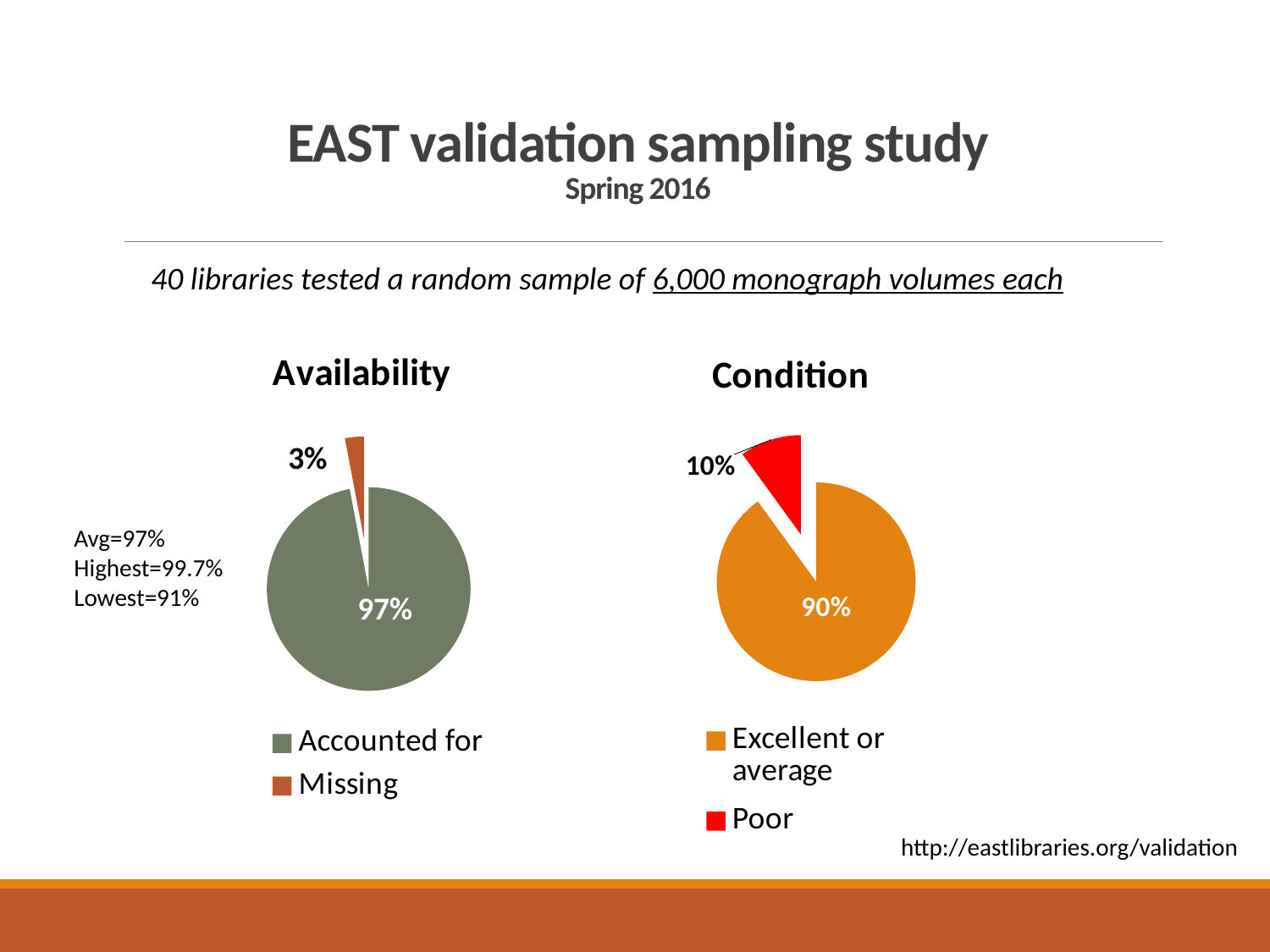
In the Condition pie chart, what percentage is labelled for Poor? 10% In the Availability pie chart, what percentage is labelled for Accounted for? 97% In the Condition pie chart, what is the difference between the Excellent or average and Poor percentages? 80% In the Availability pie chart, what is the difference between the Accounted for and Missing percentages? 94% In the Condition pie chart, what colour is the Poor slice? Red What type of chart is the Condition chart? Pie chart In the Availability pie chart, which slice is the largest? Accounted for In the Condition pie chart, what percentage is labelled for Excellent or average? 90% In the Availability pie chart, what percentage is labelled for Missing? 3% In the Condition pie chart, which slice is the smallest? Poor Which is larger: the Missing slice in the Availability chart or the Poor slice in the Condition chart? Poor How many slices does the Availability pie chart have? 2